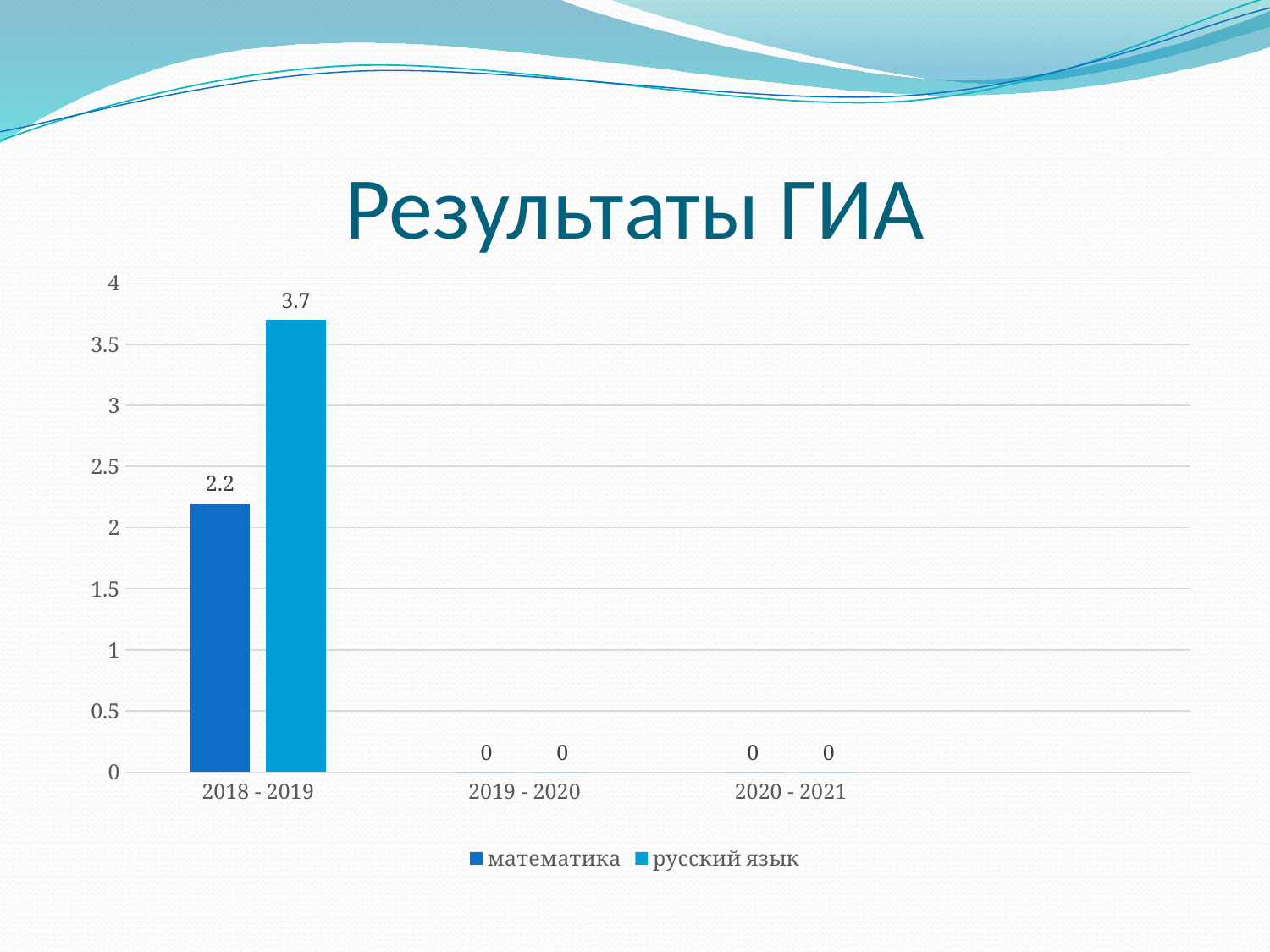
How many series does the legend list? 2 What is the value for математика in 2019 - 2020? 0 What is the value for математика in 2018 - 2019? 2.2 What is the title of the chart? Результаты ГИА How many categories are shown on the x axis? 3 Which category has the highest value for русский язык? 2018 - 2019 What kind of chart is shown on the slide? bar chart In 2018 - 2019, which is larger: математика or русский язык? русский язык What is the difference between русский язык and математика in 2018 - 2019? 1.5 What is the value for русский язык in 2018 - 2019? 3.7 Is the value for русский язык in 2018 - 2019 greater or less than 3? greater What is the value for русский язык in 2020 - 2021? 0